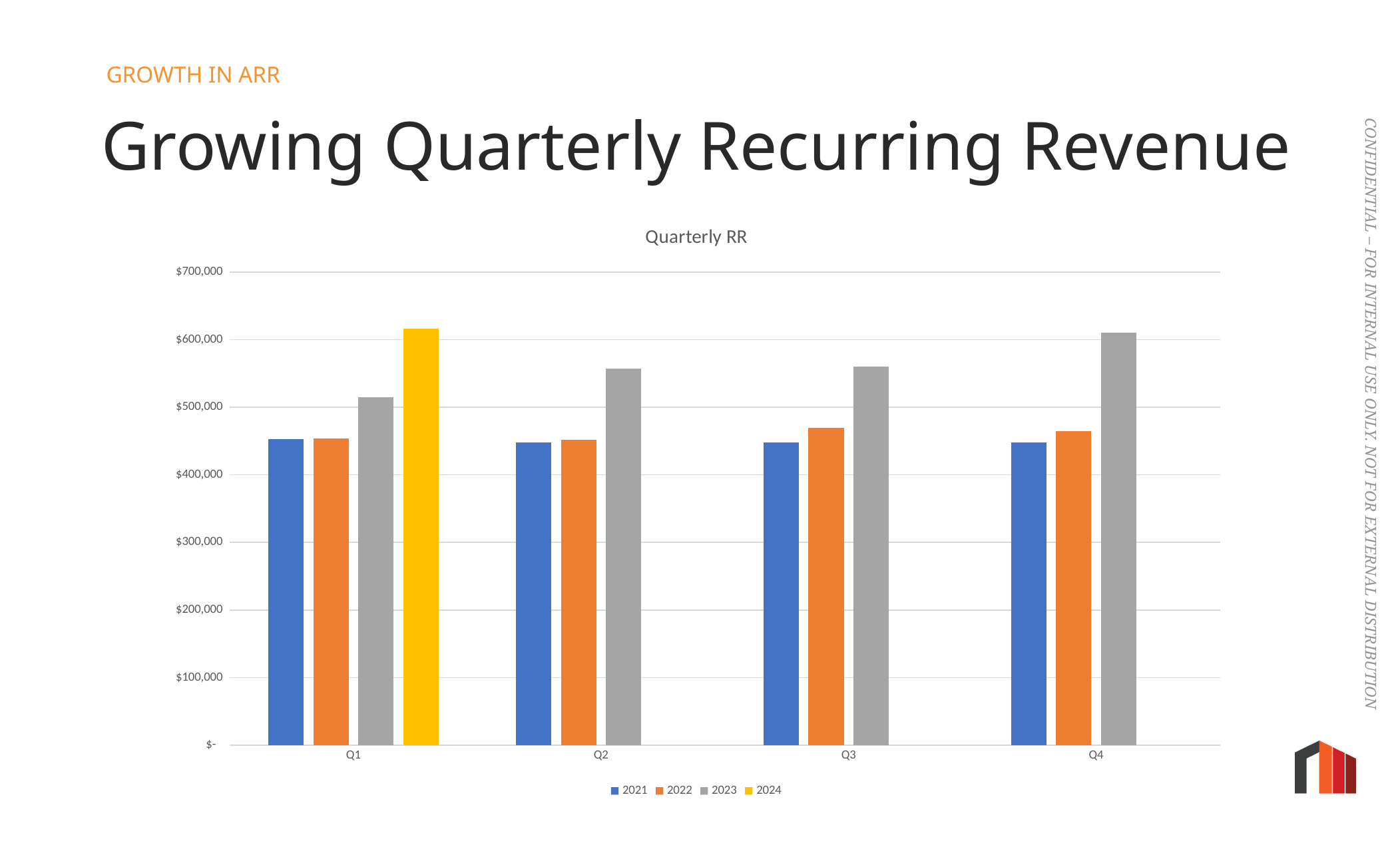
How many quarters are shown on the x axis? 4 Is the 2023 value for Q2 greater or less than $600,000? less What kind of chart is shown on the slide? bar chart Is the 2021 value for Q1 greater or less than $500,000? less In Q4, which series has the larger value, 2021 or 2023? 2023 Is the 2022 value for Q3 greater or less than $500,000? less What is the title of the chart? Quarterly RR In which quarter is the 2023 value highest? Q4 How many series does the legend list? 4 Do the 2023 values rise or fall from Q1 to Q4? rise Which series has the highest value in Q1? 2024